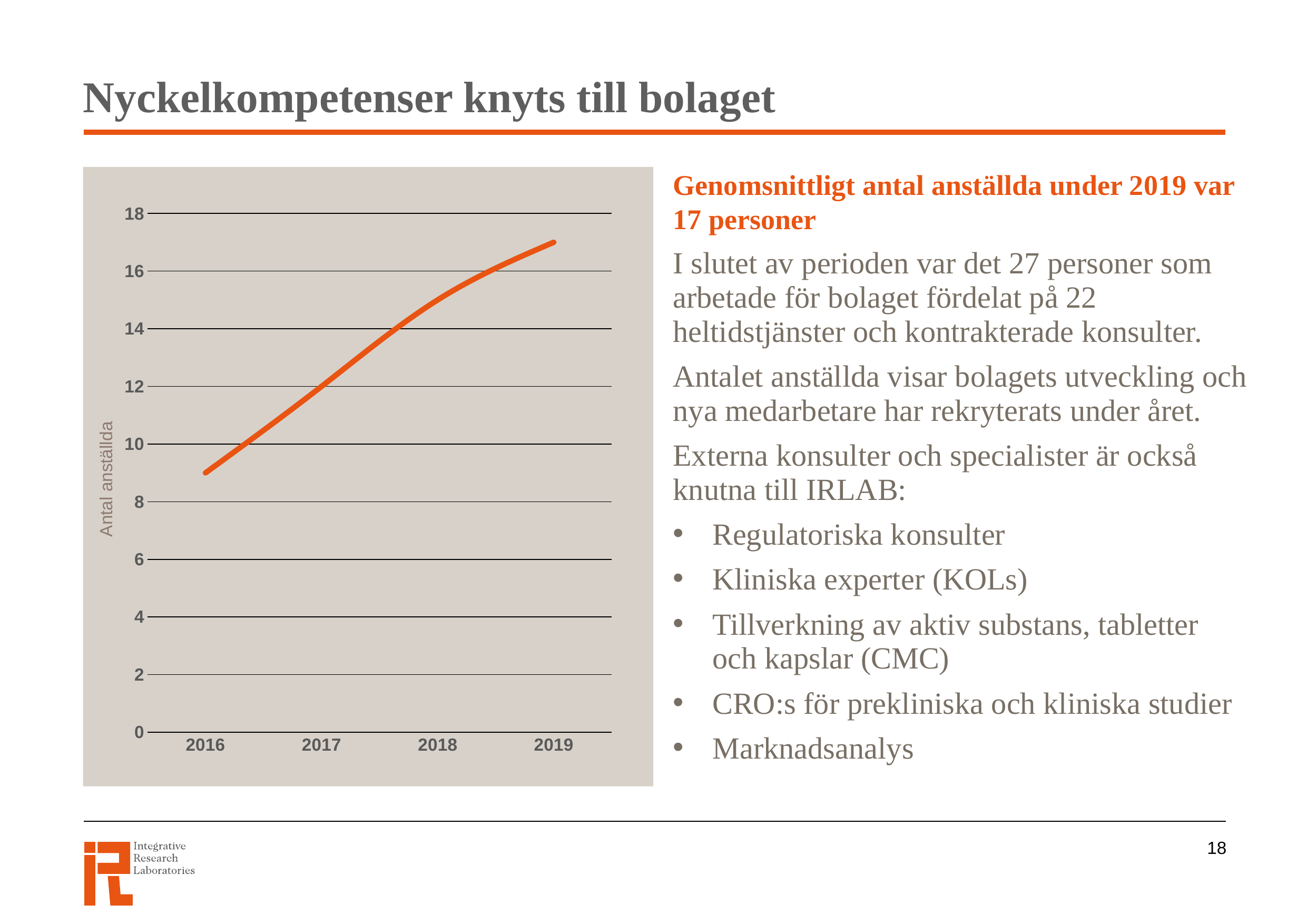
What colour is the line in the chart? orange Which year has the highest value in the chart? 2019 Is the value for 2017 greater or less than 10? greater Is the value for 2019 greater or less than 16? greater Which year has the lowest value in the chart? 2016 Is the value for 2018 greater or less than 14? greater What kind of chart is shown on the slide? line chart Which year has the larger value, 2017 or 2018? 2018 What is the label on the y axis of the chart? Antal anställda How many years are plotted on the x axis of the chart? 4 Do the values in the chart rise or fall from 2016 to 2019? rise